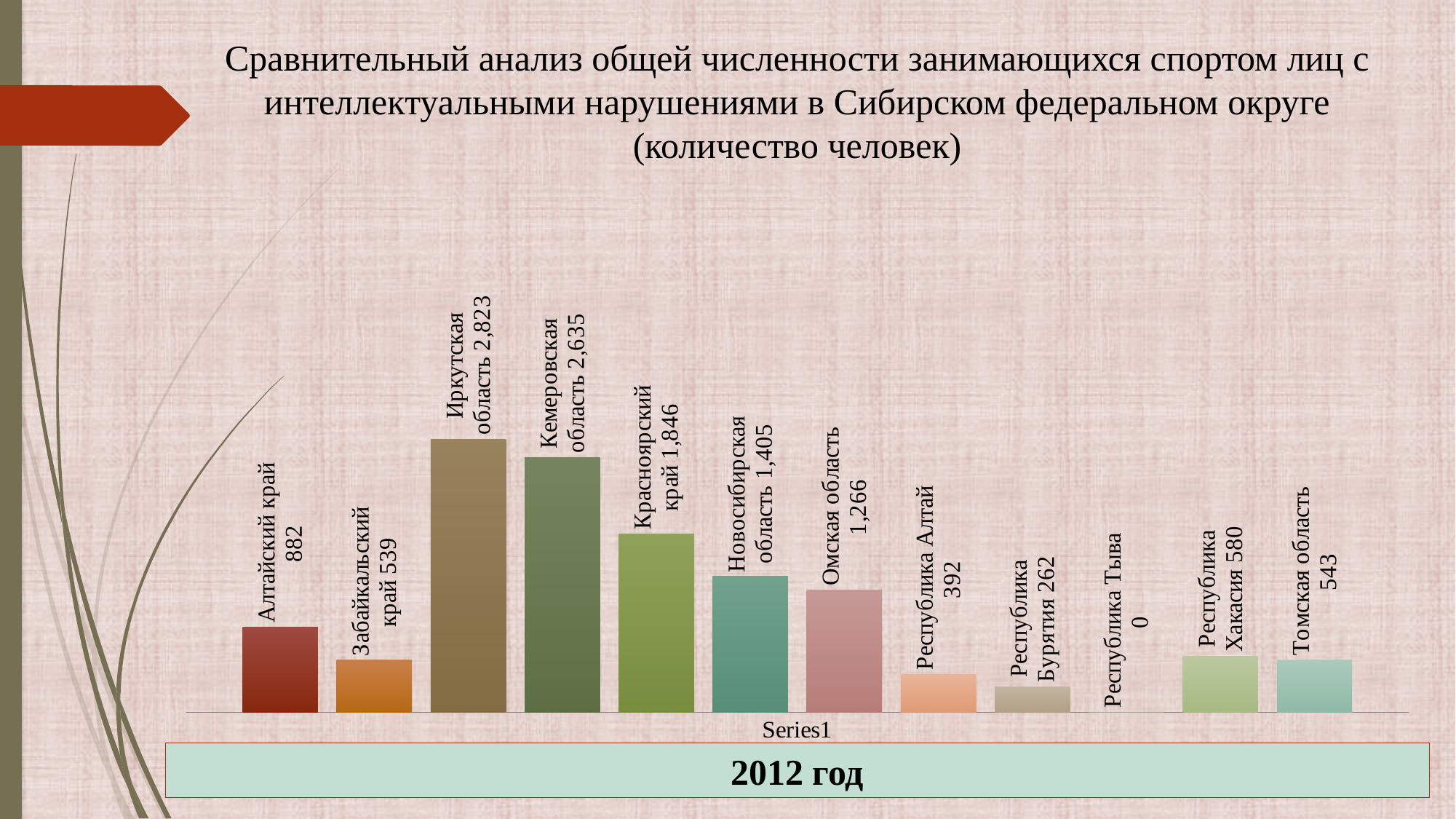
Which is larger, the value for Алтайский край or the value for Республика Хакасия? Алтайский край What is the value for Иркутская область? 2,823 What is the value for Новосибирская область? 1,405 What year is indicated in the box below the chart? 2012 год What is the value for Республика Тыва? 0 What kind of chart is shown on the slide? bar chart What is the difference between the values for Красноярский край and Омская область? 580 Which is larger, the value for Томская область or the value for Республика Алтай? Томская область How many regions (bars) are shown in the chart? 12 What is the difference between the values for Иркутская область and Кемеровская область? 188 Which region has the lowest value? Республика Тыва Which region has the highest value? Иркутская область